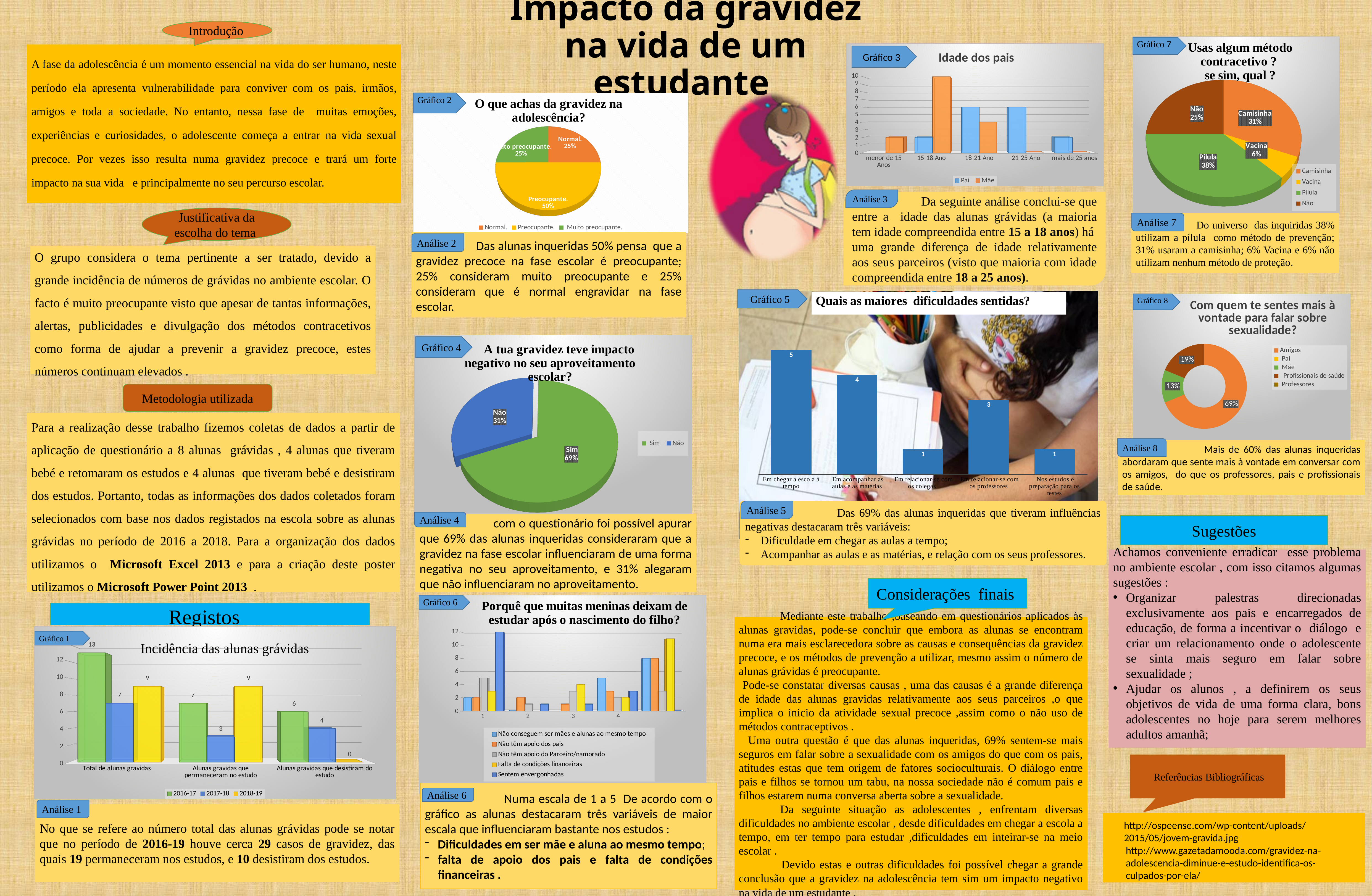
In the pie chart 'Usas algum método contracetivo? se sim, qual?' (Gráfico 7), which method has the largest share? Pilula In the pie chart 'A tua gravidez teve impacto negativo no seu aproveitamento escolar?' (Gráfico 4), what percentage answered 'Sim'? 69% In the chart 'Quais as maiores dificuldades sentidas?' (Gráfico 5), what is the value for 'Em relacionar-se com os professores'? 3 In the chart 'Incidência das alunas grávidas' (Gráfico 1), what is the difference between the 2016-17 and 2017-18 values for 'Alunas gravidas que permaneceram no estudo'? 4 In the chart 'Incidência das alunas grávidas' (Gráfico 1), what is the value for 'Total de alunas gravidas' in 2016-17? 13 In the chart 'Idade dos pais' (Gráfico 3), is the value for 'Mãe' in the '15-18 Ano' category greater or less than 8? greater In the chart 'Com quem te sentes mais à vontade para falar sobre sexualidade?' (Gráfico 8), what share is 'Amigos'? 69% In the chart 'Idade dos pais' (Gráfico 3), which category has the highest value for 'Mãe'? 15-18 Ano In the chart 'Porquê que muitas meninas deixam de estudar após o nascimento do filho?' (Gráfico 6), how many series does the legend list? 5 In the pie chart 'O que achas da gravidez na adolescência?' (Gráfico 2), what share is 'Preocupante.'? 50% In the chart 'Quais as maiores dificuldades sentidas?' (Gráfico 5), which category has the highest value? Em chegar a escola à tempo In the chart 'Incidência das alunas grávidas' (Gráfico 1), how many series does the legend list? 3